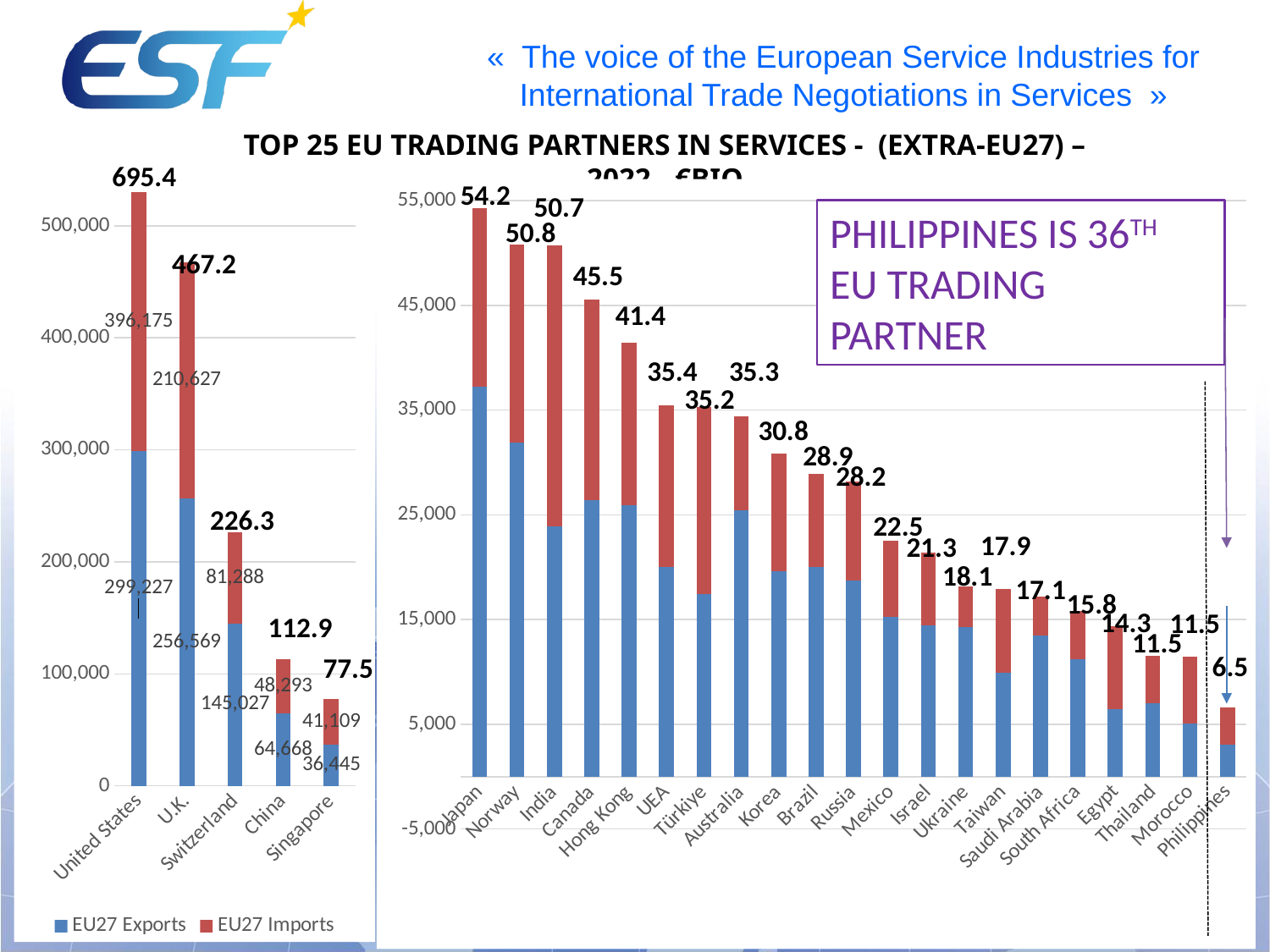
On the right chart, how many countries are shown on the x axis? 21 On the left chart, what is the EU27 Imports value for Switzerland? 81,288 On the left chart, what is the difference between the total labels for United States and U.K.? 228.2 On the right chart, what is the value labelled for Philippines? 6.5 On the right chart, do the total values generally rise or fall from left to right along the x axis? fall On the left chart, what is the total value labelled above the bar for United States? 695.4 On the left chart, what is the EU27 Exports value for the U.K.? 256,569 What kind of chart is the right chart? stacked bar chart On the left chart, how many series does the legend list? 2 On the right chart, what is the value labelled for Japan? 54.2 On the left chart, which country has the lowest total value? Singapore On the right chart, which is larger, the value for Canada or the value for Hong Kong? Canada